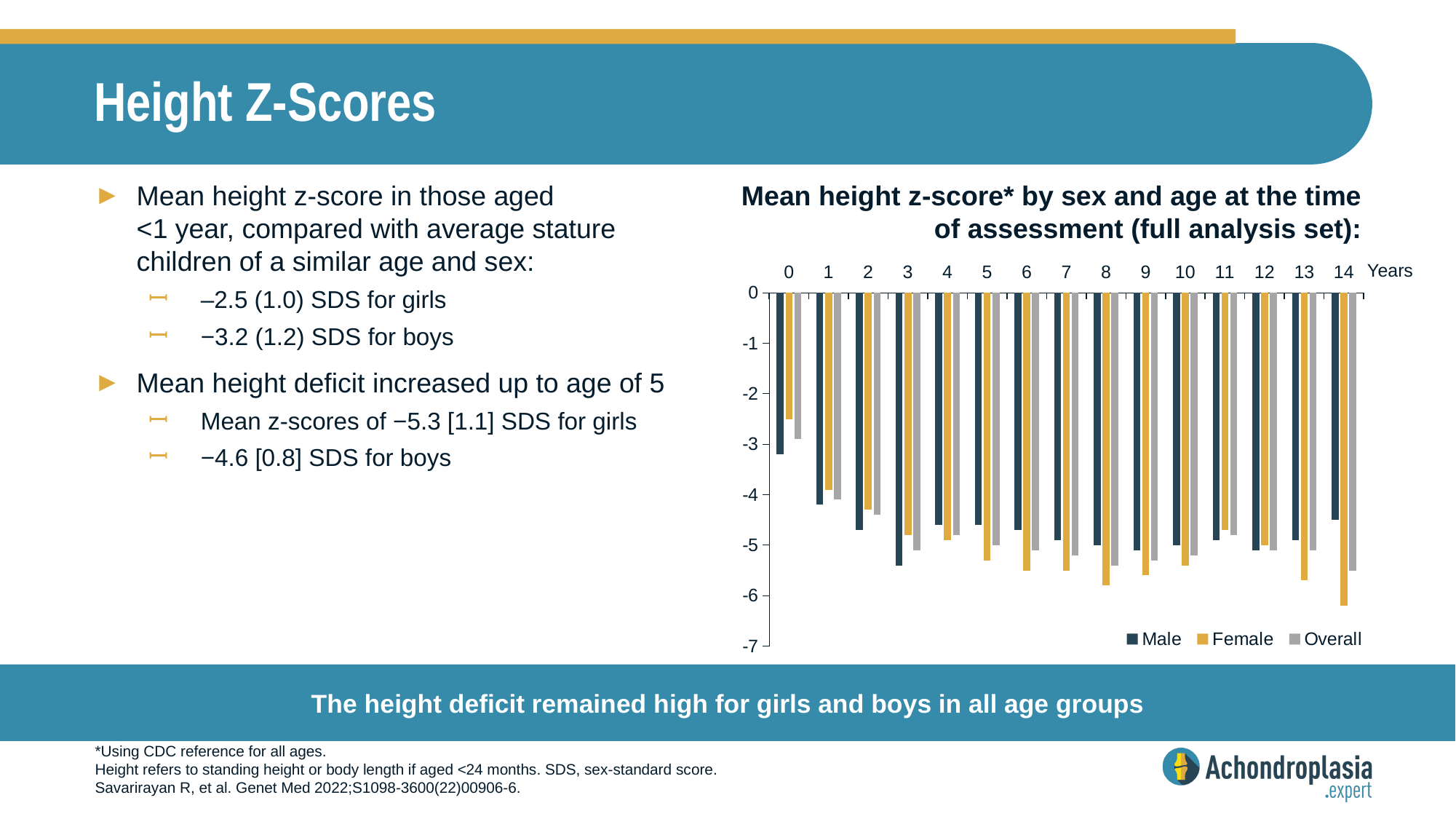
Which series are listed in the chart legend? Male, Female, Overall Is the Female value at age 0 greater or less than -3? greater At age 14, which is higher (less negative), the Male or the Female value? Male Is the Male value at age 0 greater or less than -3? less How many series does the chart legend list? 3 At which age is the Male mean height z-score highest (least negative)? 0 What kind of chart is shown on the slide? bar chart Is the Female value at age 14 greater or less than -6? less What unit label is shown at the end of the chart's x axis? Years At which age is the Female mean height z-score lowest (most negative)? 14 How many age groups are plotted along the x axis of the chart? 15